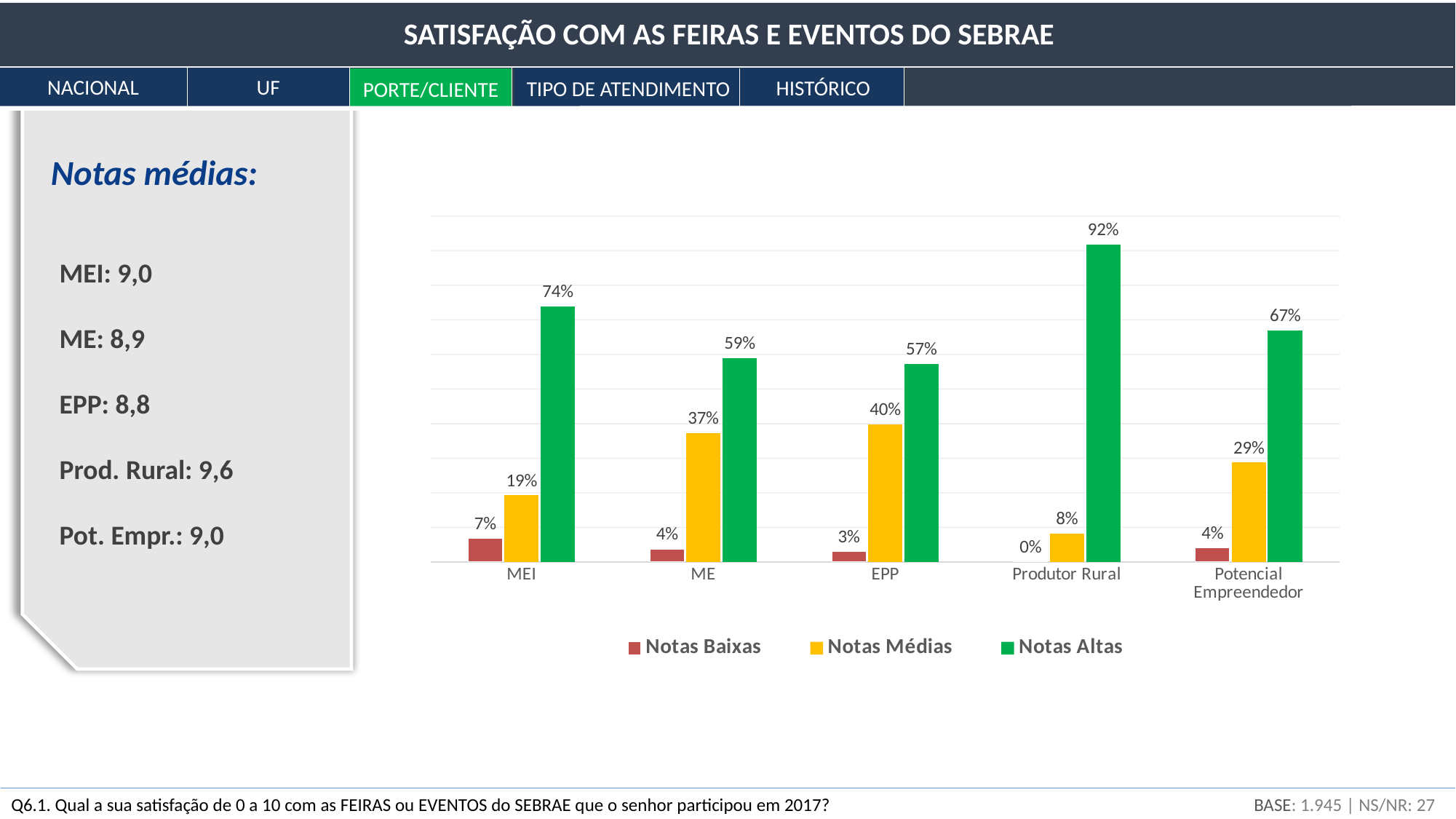
What is the difference between the Notas Altas values for MEI and ME? 15% What kind of chart is shown? Bar chart How many series does the legend list? 3 How many categories are shown on the x axis? 5 Which colour represents Notas Altas in the legend? Green Which category has the lowest Notas Baixas value? Produtor Rural What is the total of the three series for EPP? 100% What is the Notas Altas value for Produtor Rural? 92% What is the Notas Baixas value for MEI? 7% What is the Notas Médias value for EPP? 40% Which category has the highest Notas Altas value? Produtor Rural Which is larger: the Notas Médias value for ME or for Potencial Empreendedor? ME